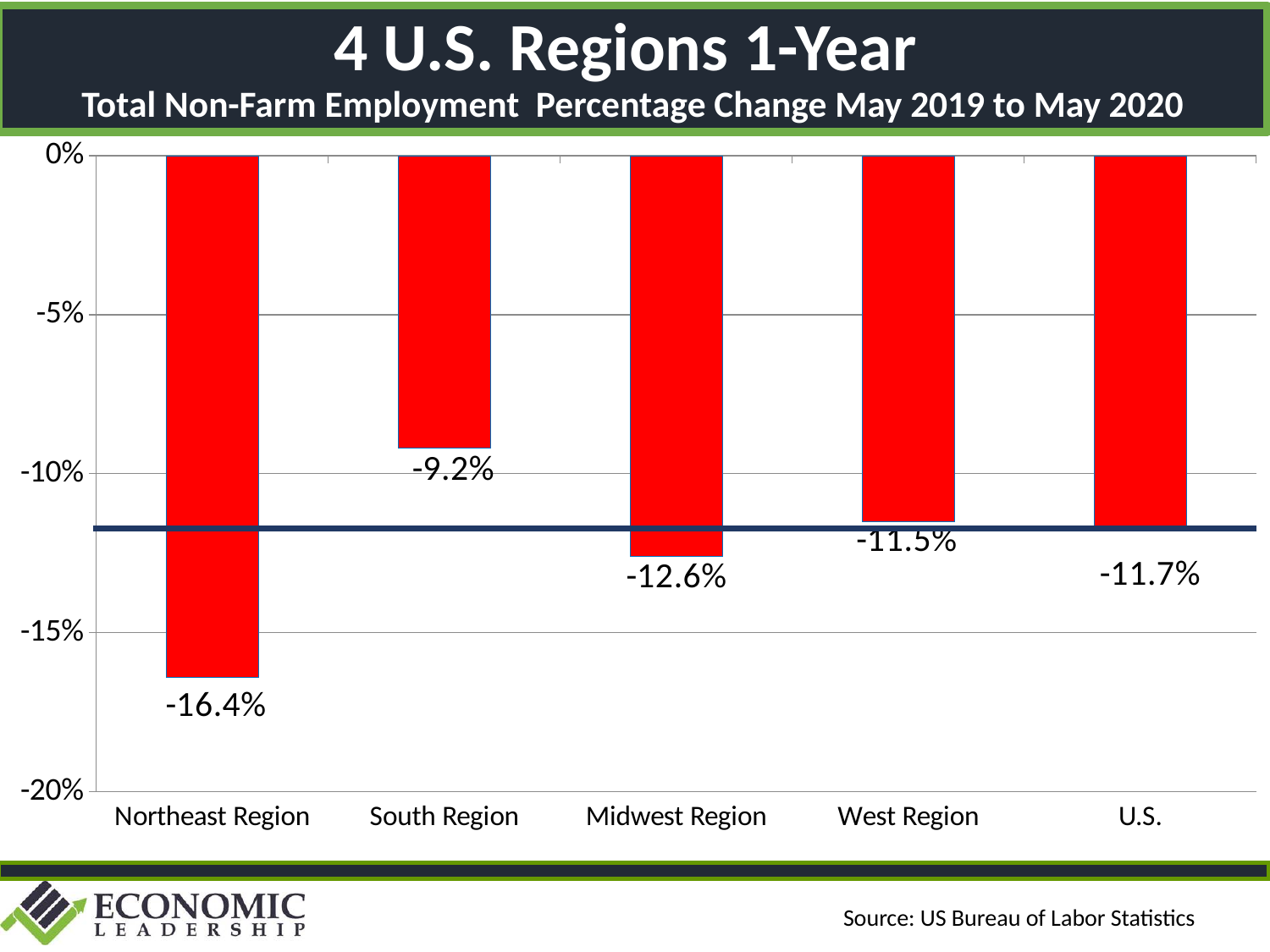
What kind of chart is shown on the slide? Bar chart What is the percentage change for the Northeast Region? -16.4% What is the difference in percentage points between the Northeast Region and the South Region? 7.2 percentage points What is the percentage change for the South Region? -9.2% Which category has the smallest decline (highest value)? South Region Is the value for the Northeast Region greater or less than -15%? less What is the percentage change for the West Region? -11.5% What is the percentage change for the Midwest Region? -12.6% What is the percentage change for the U.S. overall? -11.7% Which category has the largest decline (lowest value)? Northeast Region Which had a larger decline, the Midwest Region or the West Region? Midwest Region How many categories are shown on the x axis? 5